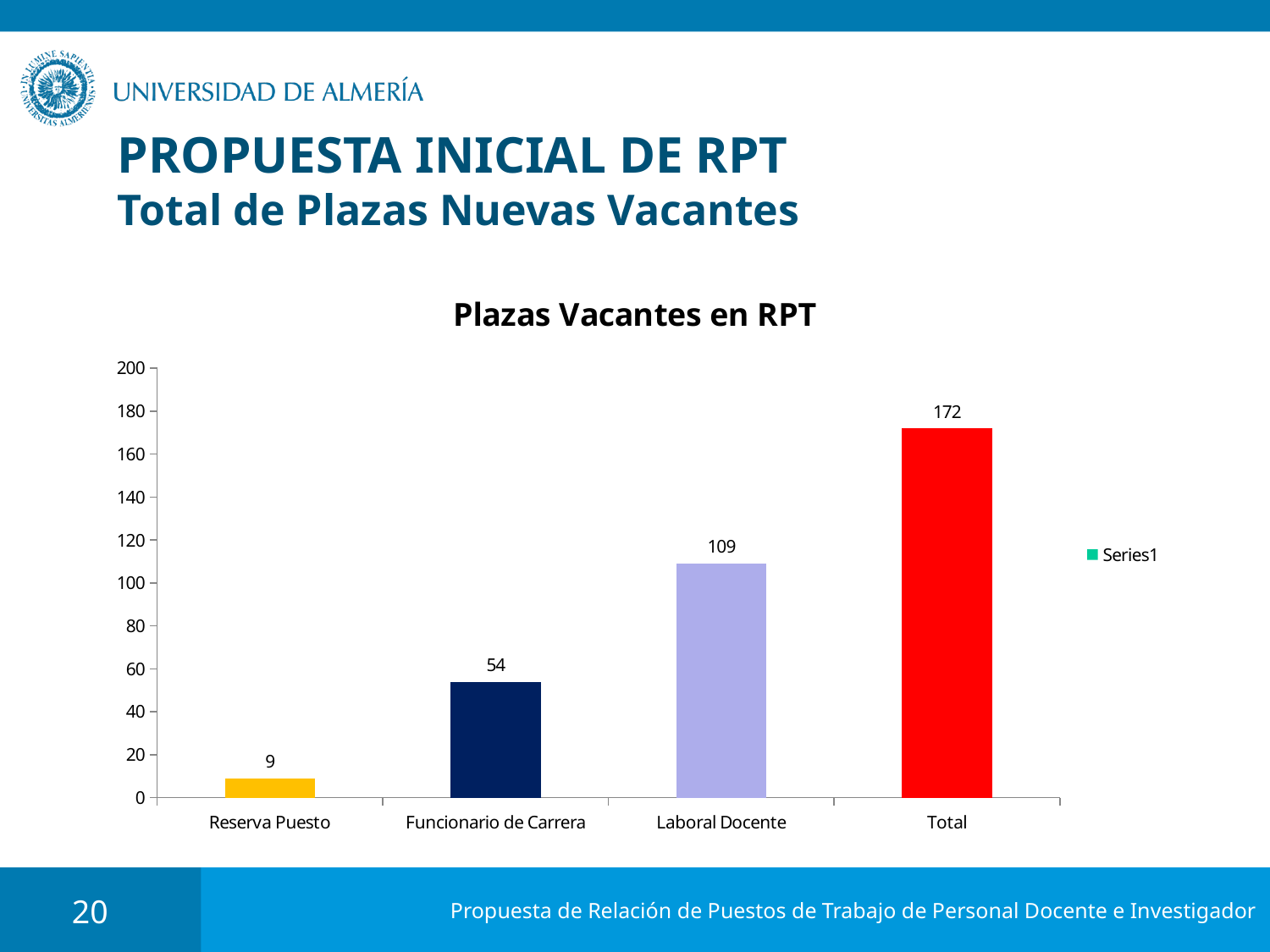
What is the value for Reserva Puesto? 9 Which category has the highest value? Total Is the value for Laboral Docente greater or less than 100? greater What is the title of the chart? Plazas Vacantes en RPT What is the value of the Total bar? 172 Which category has the lowest value? Reserva Puesto Which is larger, Funcionario de Carrera or Laboral Docente? Laboral Docente What is the difference between Laboral Docente and Funcionario de Carrera? 55 What is the value for Laboral Docente? 109 What is the value for Funcionario de Carrera? 54 What kind of chart is this? bar chart How many categories are shown on the x axis? 4